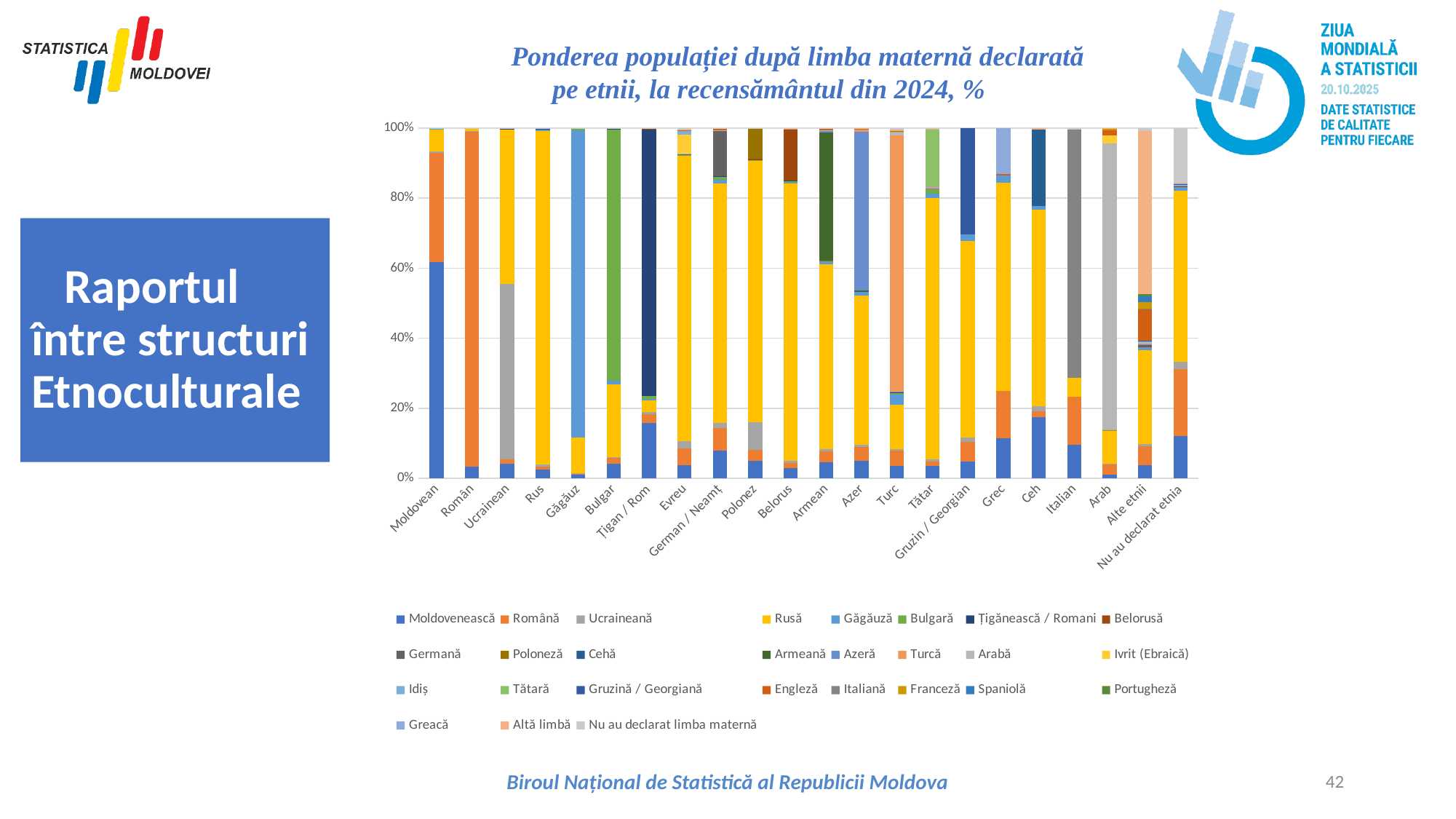
Is the Ucraineană share for the Ucrainean category greater or less than 40%? greater Is the Arabă share for the Arab category greater or less than 60%? greater What is the highest value shown on the vertical axis of the chart? 100% How many languages (series) does the chart legend list? 27 Is the Moldovenească share for the Moldovean category greater or less than 60%? greater What kind of chart is shown on the slide? stacked bar chart What is the title of the chart? Ponderea populației după limba maternă declarată pe etnii, la recensământul din 2024, % How many ethnic groups (categories) are shown along the x axis of the chart? 22